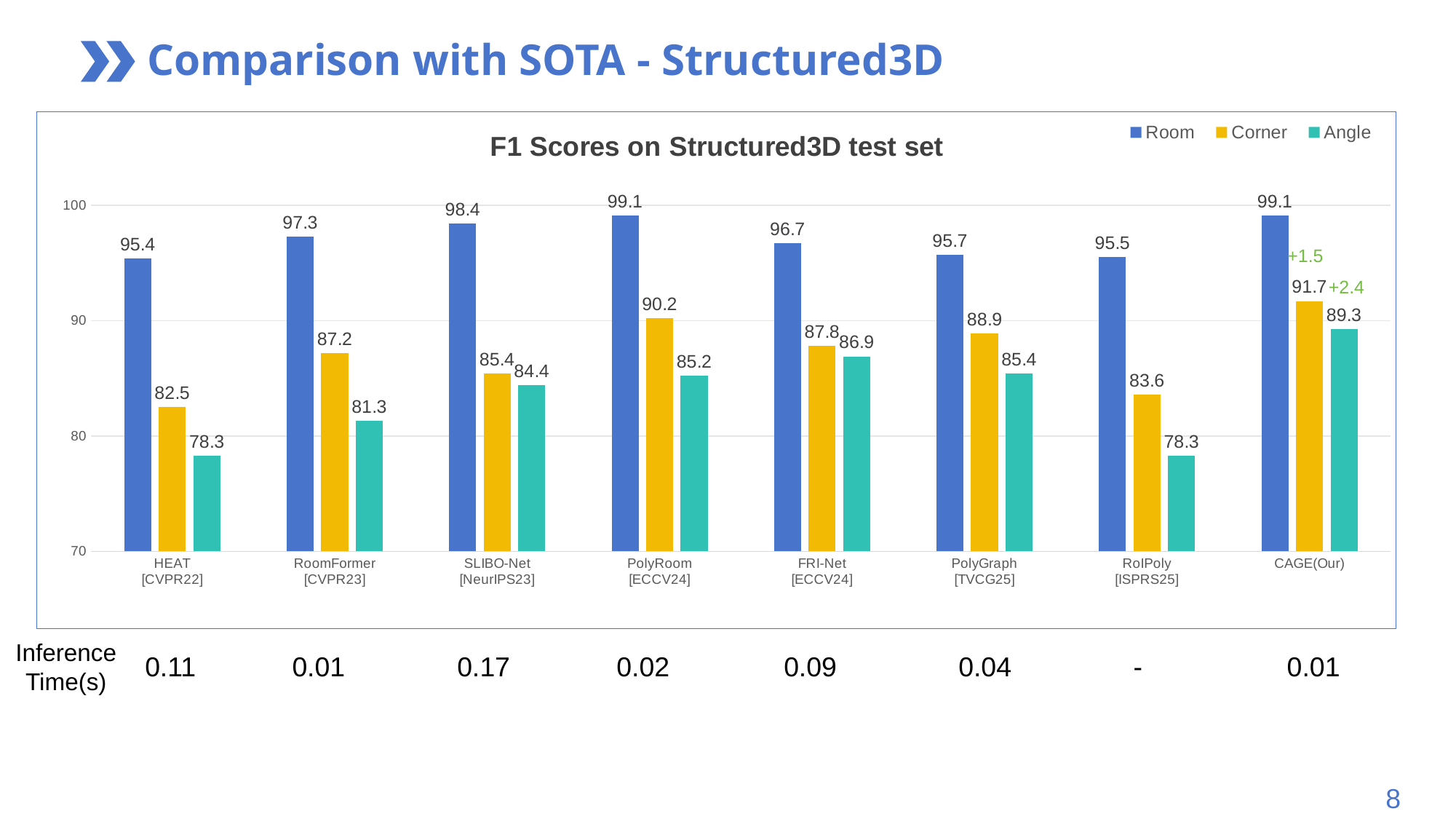
What is the Room F1 score for SLIBO-Net? 98.4 What is the difference between the Corner F1 score of CAGE(Our) and that of PolyRoom? 1.5 Which method has the highest Angle F1 score? CAGE(Our) What is the difference between the Angle F1 score of CAGE(Our) and that of FRI-Net? 2.4 What is the Corner F1 score for PolyGraph? 88.9 What is the Angle F1 score for FRI-Net? 86.9 How many methods are compared in the chart? 8 What kind of chart is shown on the slide? Bar chart Which method has the lowest Corner F1 score? HEAT Which method has the highest Corner F1 score? CAGE(Our) Which is larger, the Corner F1 score of RoomFormer or the Corner F1 score of RoIPoly? RoomFormer How many series does the legend list? 3